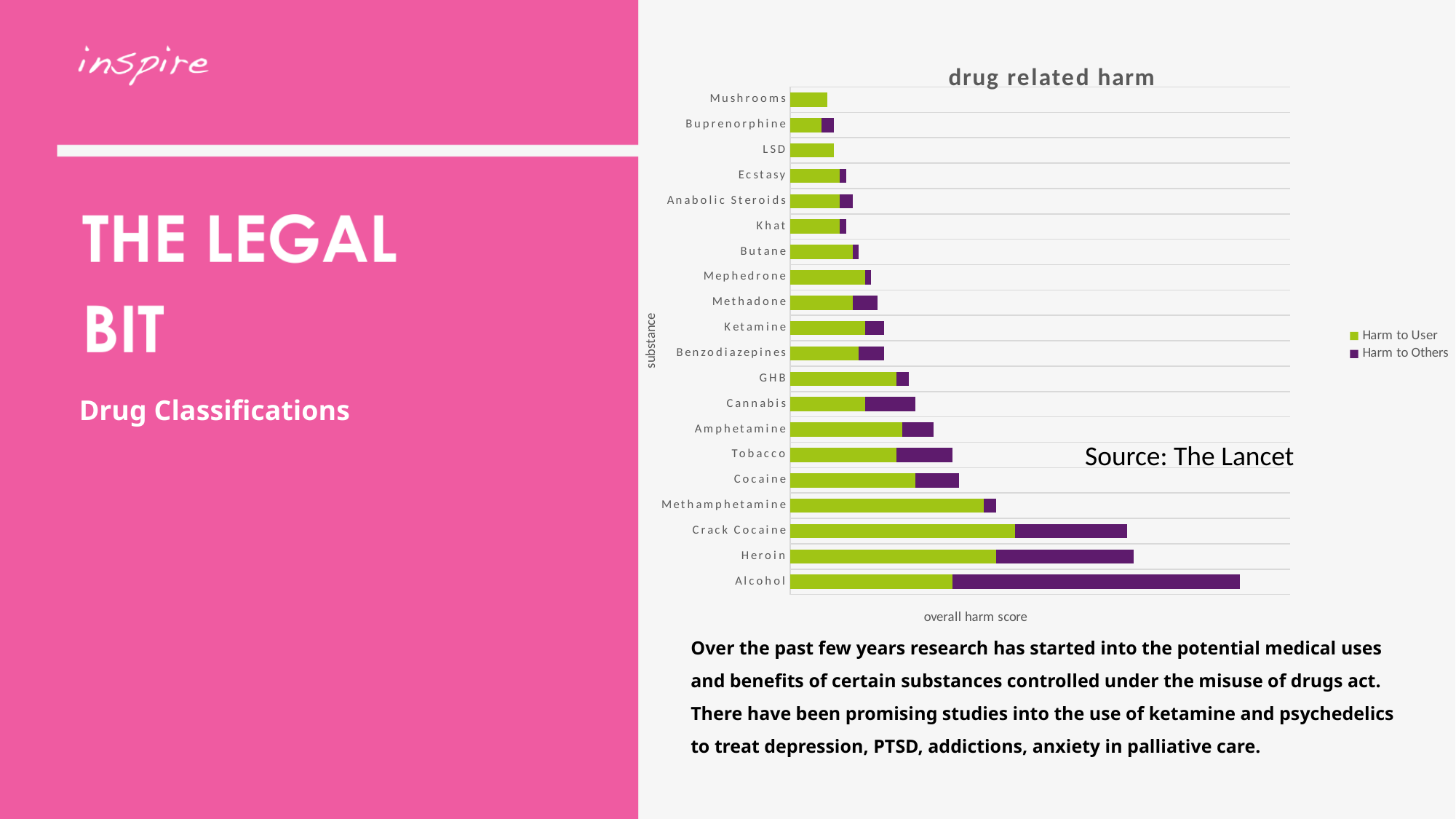
Which has the larger overall harm score, LSD or Tobacco? Tobacco Which substance has the largest Harm to Others value? Alcohol Which substance has the lowest overall harm score? Mushrooms What are the two series named in the legend? Harm to User and Harm to Others What kind of chart is shown on the slide? Stacked bar chart How many series does the chart's legend list? 2 How many substances are plotted on the chart? 20 Which has the larger overall harm score, Alcohol or Heroin? Alcohol Which has the larger Harm to Others value, Crack Cocaine or Methamphetamine? Crack Cocaine What is the title of the chart? drug related harm Which substance has the highest overall harm score? Alcohol